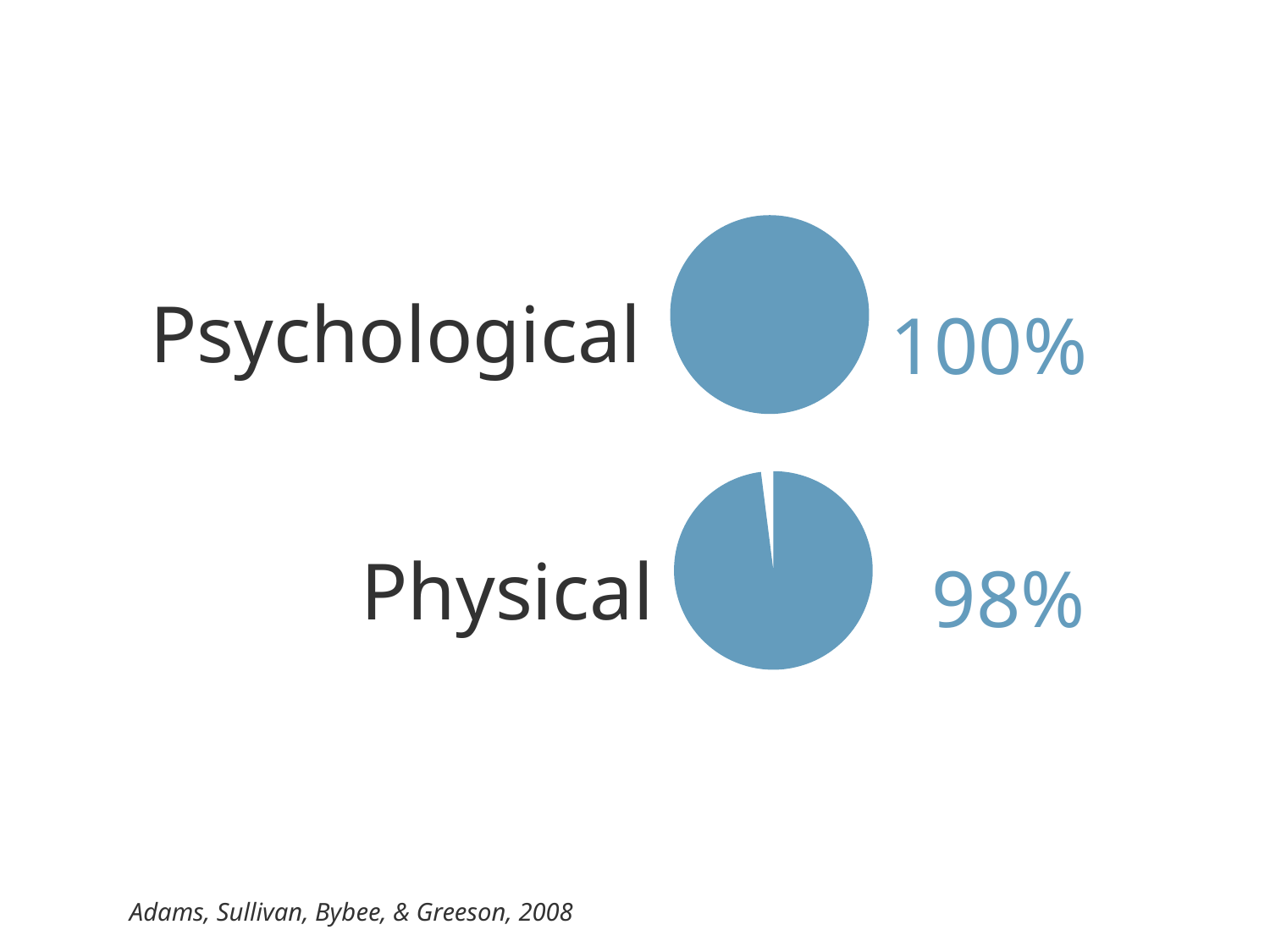
Which category has the higher percentage, Psychological or Physical? Psychological What source citation is shown at the bottom of the slide? Adams, Sullivan, Bybee, & Greeson, 2008 What kind of chart is used to show each percentage on the slide? Pie chart What colour are the pie charts on the slide? Blue Is the value for Physical greater or less than 50%? greater How many categories are shown on the slide? 2 What percentage is shown for Psychological? 100% How many pie charts are on the slide? 2 Which category shows the lowest percentage? Physical What is the difference between the Psychological and Physical percentages? 2% What percentage is shown for Physical? 98% Which category shows the highest percentage? Psychological